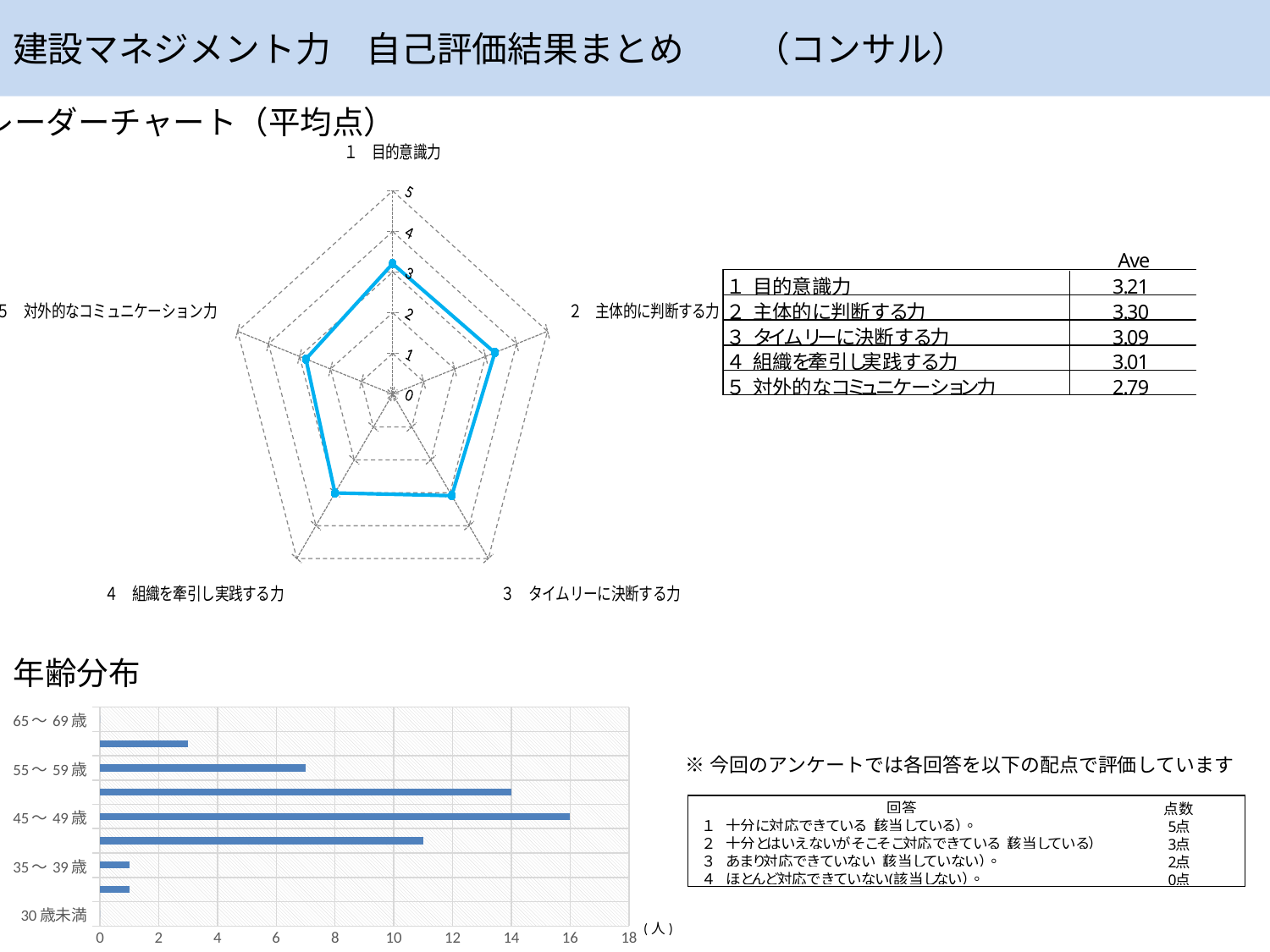
In the radar chart レーダーチャート（平均点）, how many axes (categories) are plotted? 5 What kind of chart is the upper chart titled レーダーチャート（平均点）? Radar chart In the radar chart レーダーチャート（平均点）, what is the average score for 5 対外的なコミュニケーション力? 2.79 In the radar chart レーダーチャート（平均点）, which category has the lowest average score? 5 対外的なコミュニケーション力 What kind of chart is the lower chart titled 年齢分布? Bar chart In the radar chart レーダーチャート（平均点）, is the value for 2 主体的に判断する力 greater or less than 4? less In the 年齢分布 bar chart, what unit is shown at the end of the horizontal axis? （人） In the radar chart レーダーチャート（平均点）, which category has the highest average score? 2 主体的に判断する力 In the radar chart レーダーチャート（平均点）, what is the average score for 1 目的意識力 as shown in the table? 3.21 In the 年齢分布 bar chart, is the value for 45～49歳 greater or less than 10? greater In the radar chart レーダーチャート（平均点）, what is the difference between the highest score (2 主体的に判断する力) and the lowest score (5 対外的なコミュニケーション力)? 0.51 In the radar chart レーダーチャート（平均点）, which has the larger average score: 3 タイムリーに決断する力 or 4 組織を牽引し実践する力? 3 タイムリーに決断する力